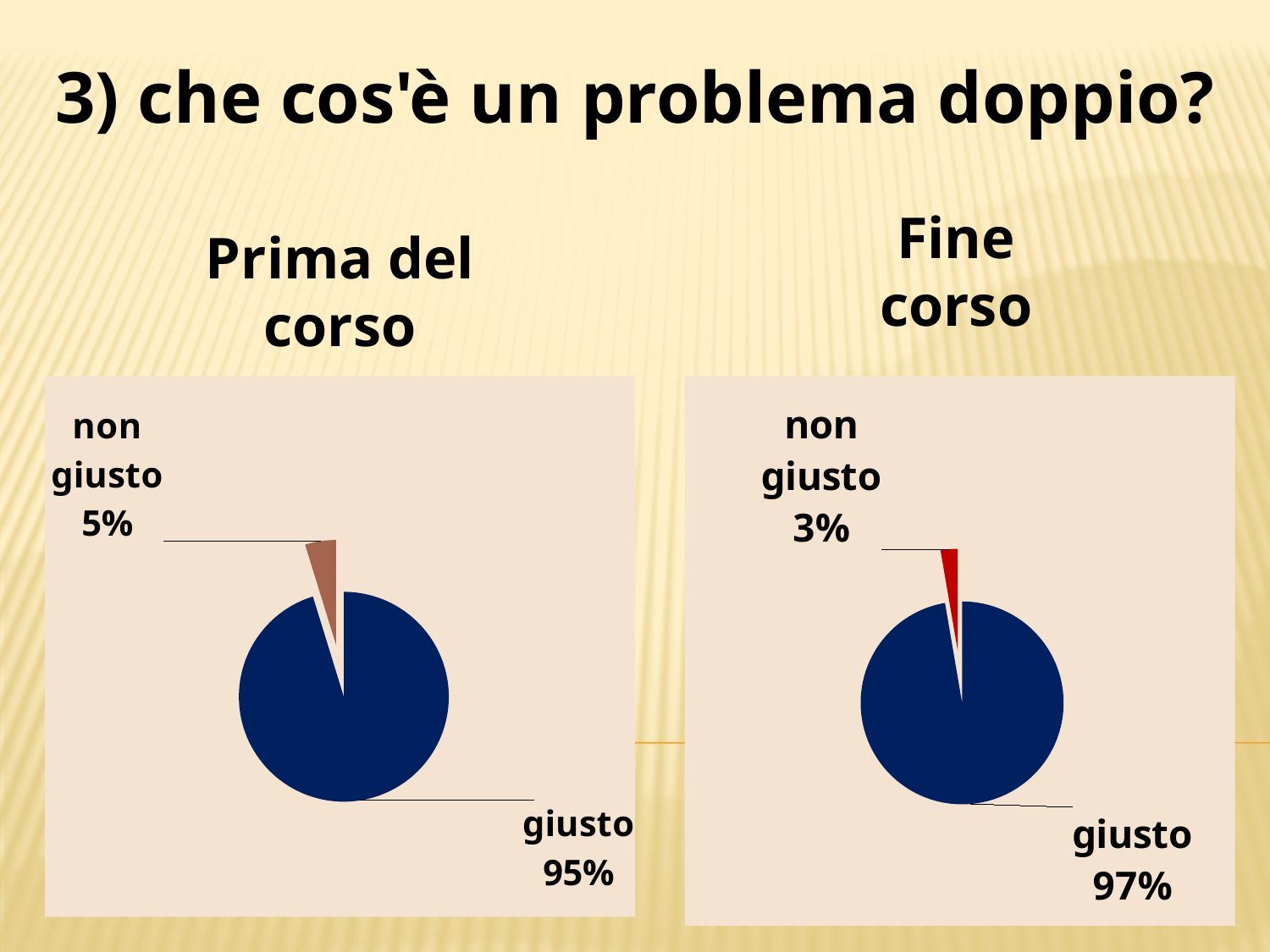
How many charts are shown on the slide? 2 What type of chart is used on the left of the slide? Pie chart In the 'Prima del corso' pie chart, what share is labelled 'giusto'? 95% In the 'Prima del corso' pie chart, which slice is the largest? giusto In the 'Fine corso' pie chart, what share is labelled 'non giusto'? 3% In the 'Prima del corso' pie chart, what share is labelled 'non giusto'? 5% In the 'Fine corso' pie chart, which slice is the smallest? non giusto In the 'Fine corso' pie chart, what share is labelled 'giusto'? 97% What is the title of the chart on the right of the slide? Fine corso How many slices does the 'Prima del corso' pie chart have? 2 Is the 'non giusto' share larger in the 'Prima del corso' chart or in the 'Fine corso' chart? Prima del corso What is the difference between the 'giusto' share in the 'Fine corso' chart and the 'giusto' share in the 'Prima del corso' chart? 2%